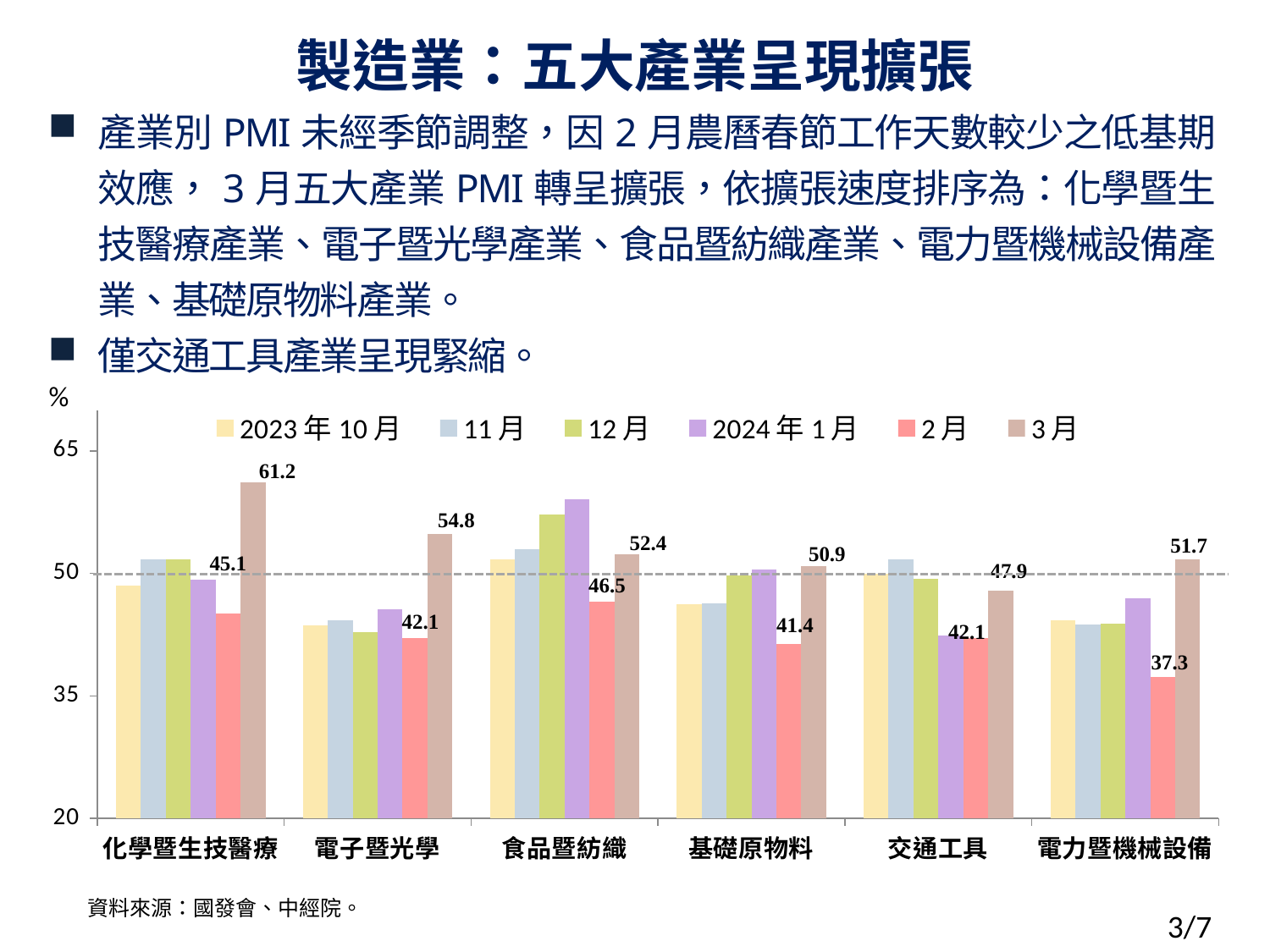
Which industry has the lowest 2月 value? 電力暨機械設備 What is the 3月 value for 基礎原物料? 50.9 What is the 3月 value for 化學暨生技醫療? 61.2 Which is larger, the 3月 value for 食品暨紡織 or the 3月 value for 電力暨機械設備? 食品暨紡織 What value does the dashed horizontal reference line mark on the y axis? 50 What is the difference between the 3月 and 2月 values for 電子暨光學? 12.7 What is the 2月 value for 電力暨機械設備? 37.3 Which industry has the highest 3月 value? 化學暨生技醫療 How many series does the legend list? 6 Is the 2024 年 1 月 value for 食品暨紡織 greater or less than 50? greater What kind of chart is shown on the slide? bar chart How many industry categories are shown on the x axis? 6